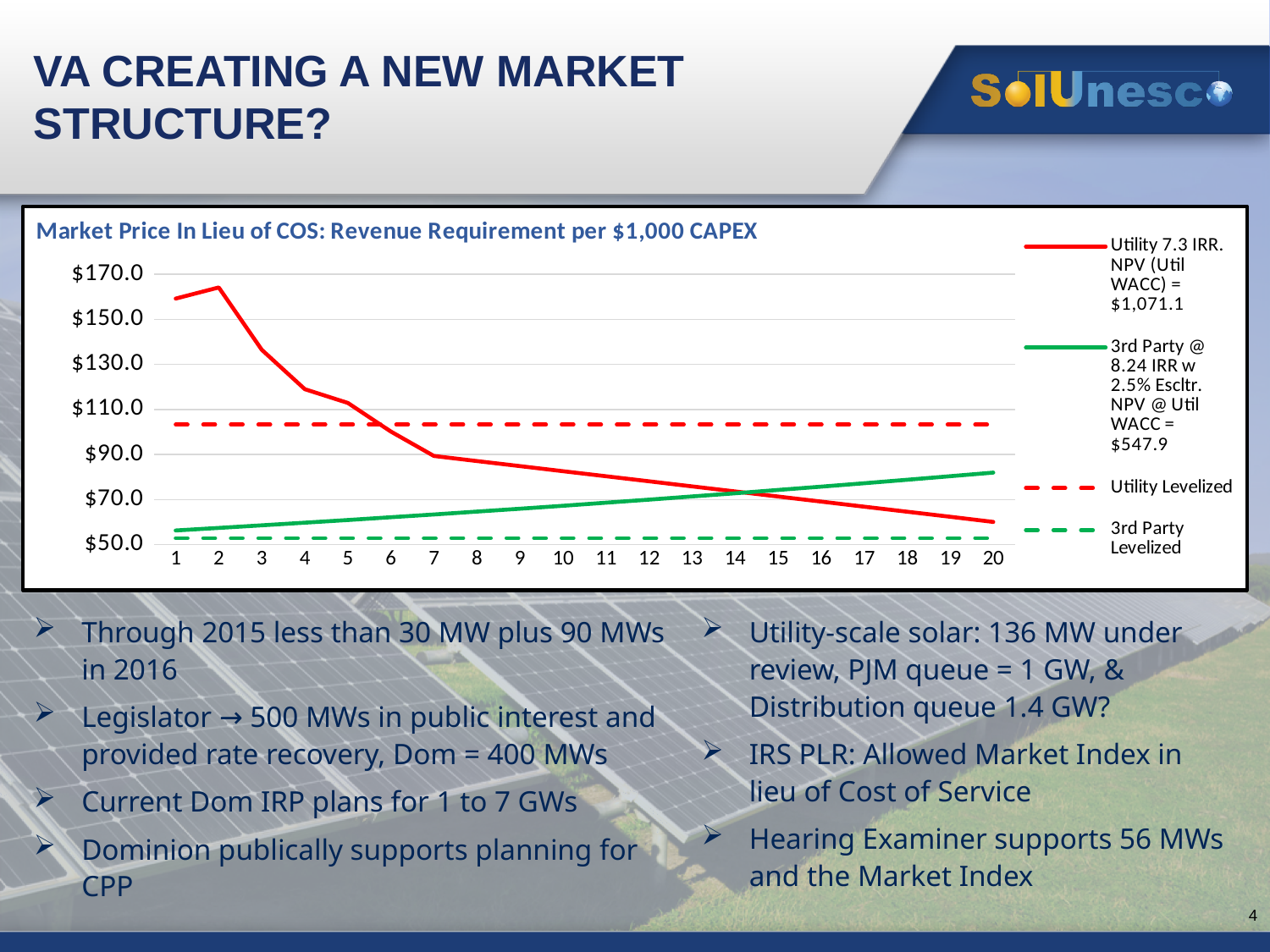
What is the title of the chart? Market Price In Lieu of COS: Revenue Requirement per $1,000 CAPEX Is the value of the Utility 7.3 IRR line at year 20 greater or less than $70.0? less How many points are plotted along the x axis of the chart? 20 What kind of chart is shown on the slide? line chart Does the 3rd Party @ 8.24 IRR line rise or fall from year 1 to year 20? rise Does the Utility 7.3 IRR line rise or fall from year 1 to year 20? fall Is the Utility Levelized dashed line greater or less than $90.0? greater How many series does the chart legend list? 4 At year 20, which is larger: the Utility 7.3 IRR line or the 3rd Party @ 8.24 IRR line? 3rd Party @ 8.24 IRR Is the value of the Utility 7.3 IRR line at year 1 greater or less than $150.0? greater At year 1, which is larger: the Utility 7.3 IRR line or the 3rd Party @ 8.24 IRR line? Utility 7.3 IRR